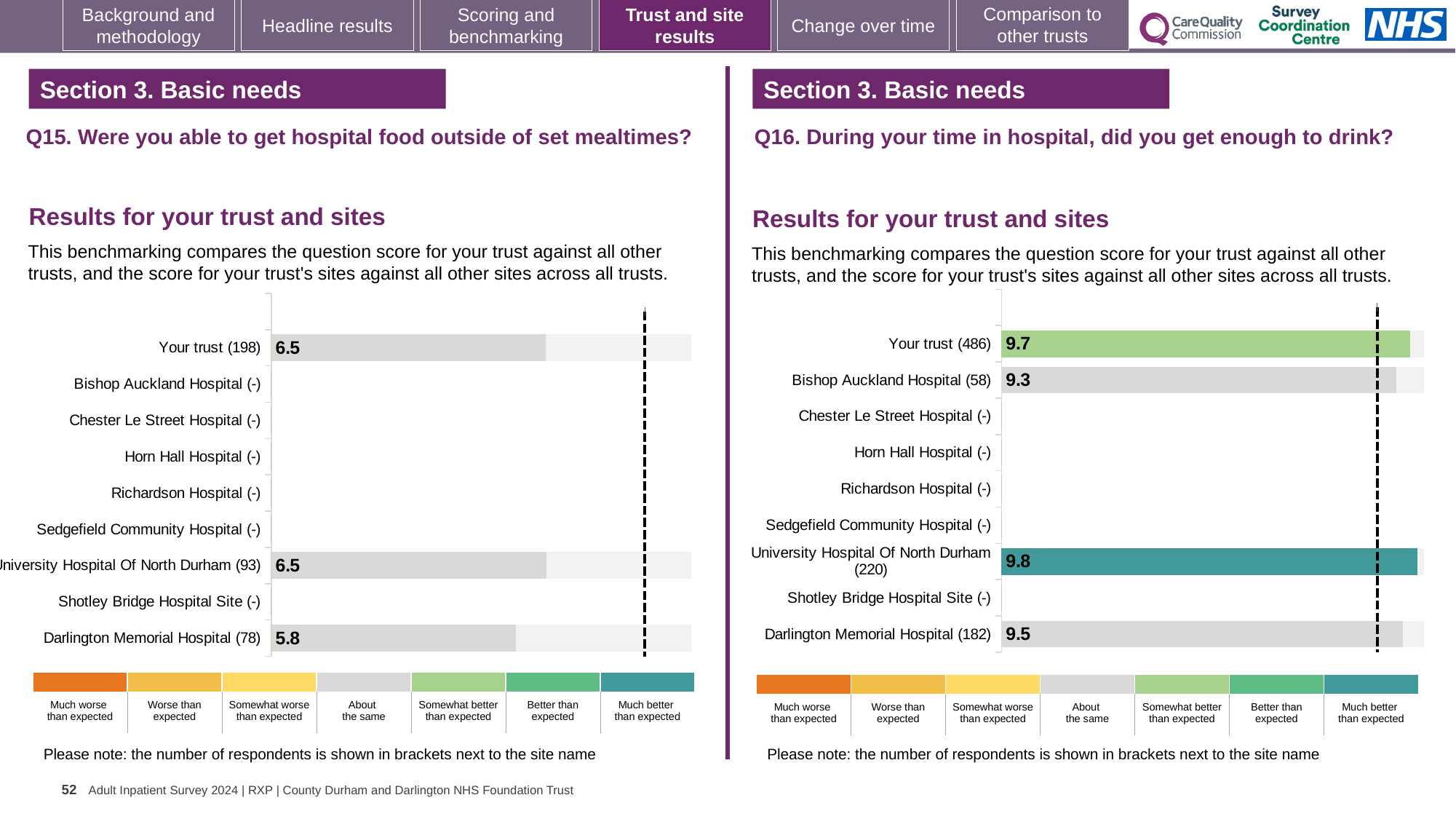
In the Q16 chart (right), which is larger: the score for Darlington Memorial Hospital or the score for Bishop Auckland Hospital? Darlington Memorial Hospital What kind of chart is used for the Q16 results (right)? Bar chart In the Q15 chart (left), what is the score for University Hospital Of North Durham? 6.5 In the Q16 chart (right), what is the score for Bishop Auckland Hospital? 9.3 In the Q15 chart (left), what is the score for Darlington Memorial Hospital? 5.8 In the Q16 chart (right), what is the difference between the score for University Hospital Of North Durham and the score for Bishop Auckland Hospital? 0.5 In the Q16 chart (right), what is the score for Your trust? 9.7 In the Q16 chart (right), which site has the lowest score among those with a plotted bar? Bishop Auckland Hospital How many site rows (categories) are listed on the y axis of the Q15 chart (left)? 9 In the Q15 chart (left), what is the difference between the score for Your trust and the score for Darlington Memorial Hospital? 0.7 In the Q16 chart (right), which site has the highest score? University Hospital Of North Durham In the Q15 chart (left), what is the score for Your trust? 6.5